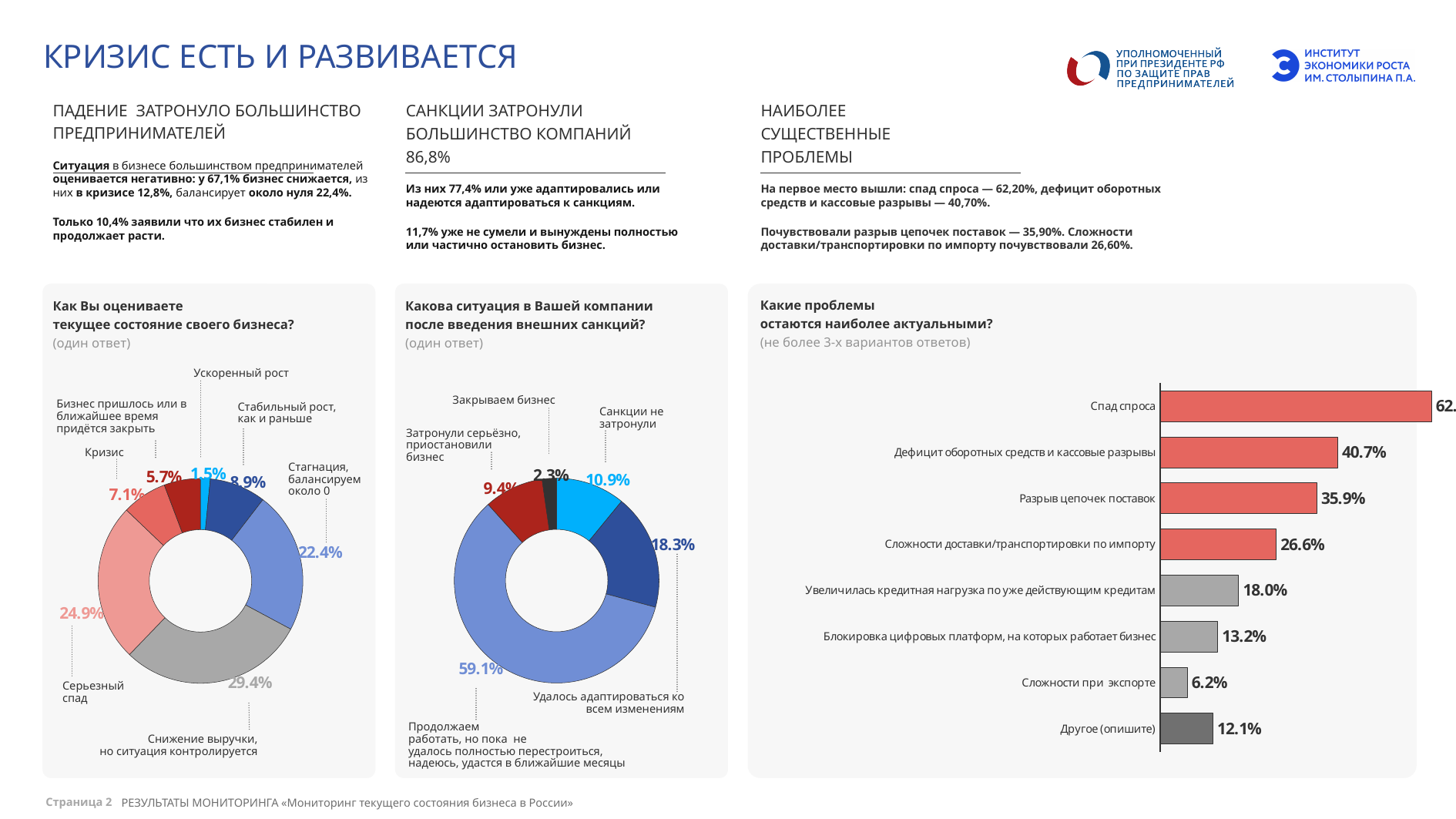
What type of chart is 'Как Вы оцениваете текущее состояние своего бизнеса?'? Donut (pie) chart On the donut chart 'Какова ситуация в Вашей компании после введения внешних санкций?', what is the share for 'Санкции не затронули'? 10.9% On the bar chart 'Какие проблемы остаются наиболее актуальными?', how many categories are shown? 8 On the donut chart 'Как Вы оцениваете текущее состояние своего бизнеса?', what is the share for 'Серьезный спад'? 24.9% On the donut chart 'Какова ситуация в Вашей компании после введения внешних санкций?', how many categories are shown? 5 On the donut chart 'Как Вы оцениваете текущее состояние своего бизнеса?', which category has the smallest share? Ускоренный рост On the bar chart 'Какие проблемы остаются наиболее актуальными?', what is the value for 'Сложности при экспорте'? 6.2% On the bar chart 'Какие проблемы остаются наиболее актуальными?', which is larger: 'Блокировка цифровых платформ, на которых работает бизнес' or 'Другое (опишите)'? Блокировка цифровых платформ, на которых работает бизнес On the bar chart 'Какие проблемы остаются наиболее актуальными?', which category has the lowest value? Сложности при экспорте On the bar chart 'Какие проблемы остаются наиболее актуальными?', which category has the highest value? Спад спроса On the bar chart 'Какие проблемы остаются наиболее актуальными?', what is the value for 'Дефицит оборотных средств и кассовые разрывы'? 40.7% On the bar chart 'Какие проблемы остаются наиболее актуальными?', what is the difference between 'Разрыв цепочек поставок' and 'Сложности доставки/транспортировки по импорту'? 9.3%